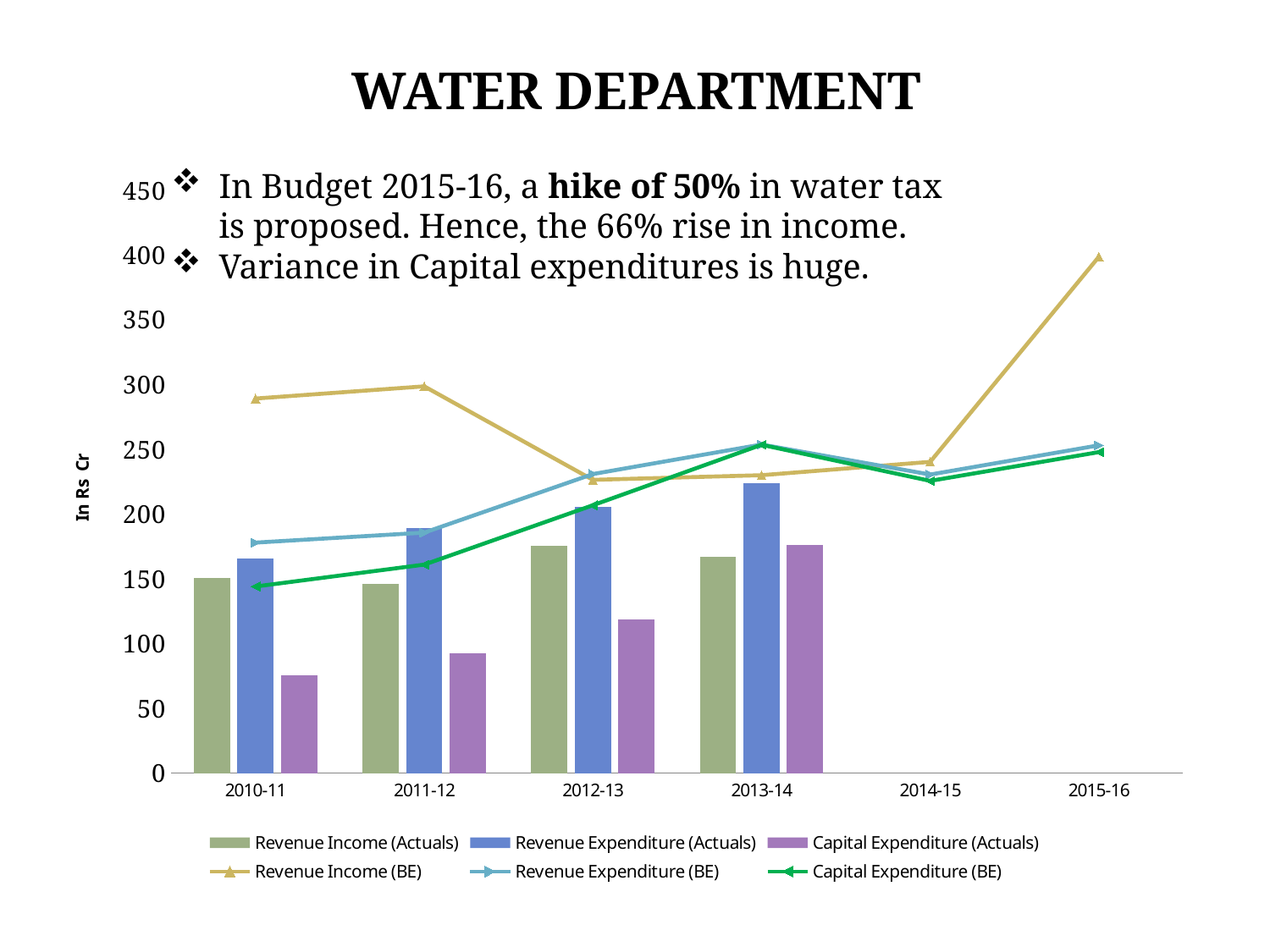
Is the value for Capital Expenditure (Actuals) in 2010-11 greater or less than 100? less What is the label on the vertical axis of the chart? In Rs Cr How many fiscal-year categories are shown on the x axis? 6 In which year is Capital Expenditure (Actuals) lowest? 2010-11 Do the Capital Expenditure (Actuals) bars rise or fall from 2010-11 to 2013-14? rise Is the value for Revenue Income (BE) in 2015-16 greater or less than 350? greater In 2013-14, which is larger: Revenue Expenditure (Actuals) or Revenue Income (Actuals)? Revenue Expenditure (Actuals) What kind of chart is shown on the slide? Combination bar and line chart How many series does the chart legend list? 6 In which year is Revenue Income (BE) highest? 2015-16 Is the value for Revenue Expenditure (Actuals) in 2013-14 greater or less than 200? greater In which year is Revenue Expenditure (Actuals) highest? 2013-14